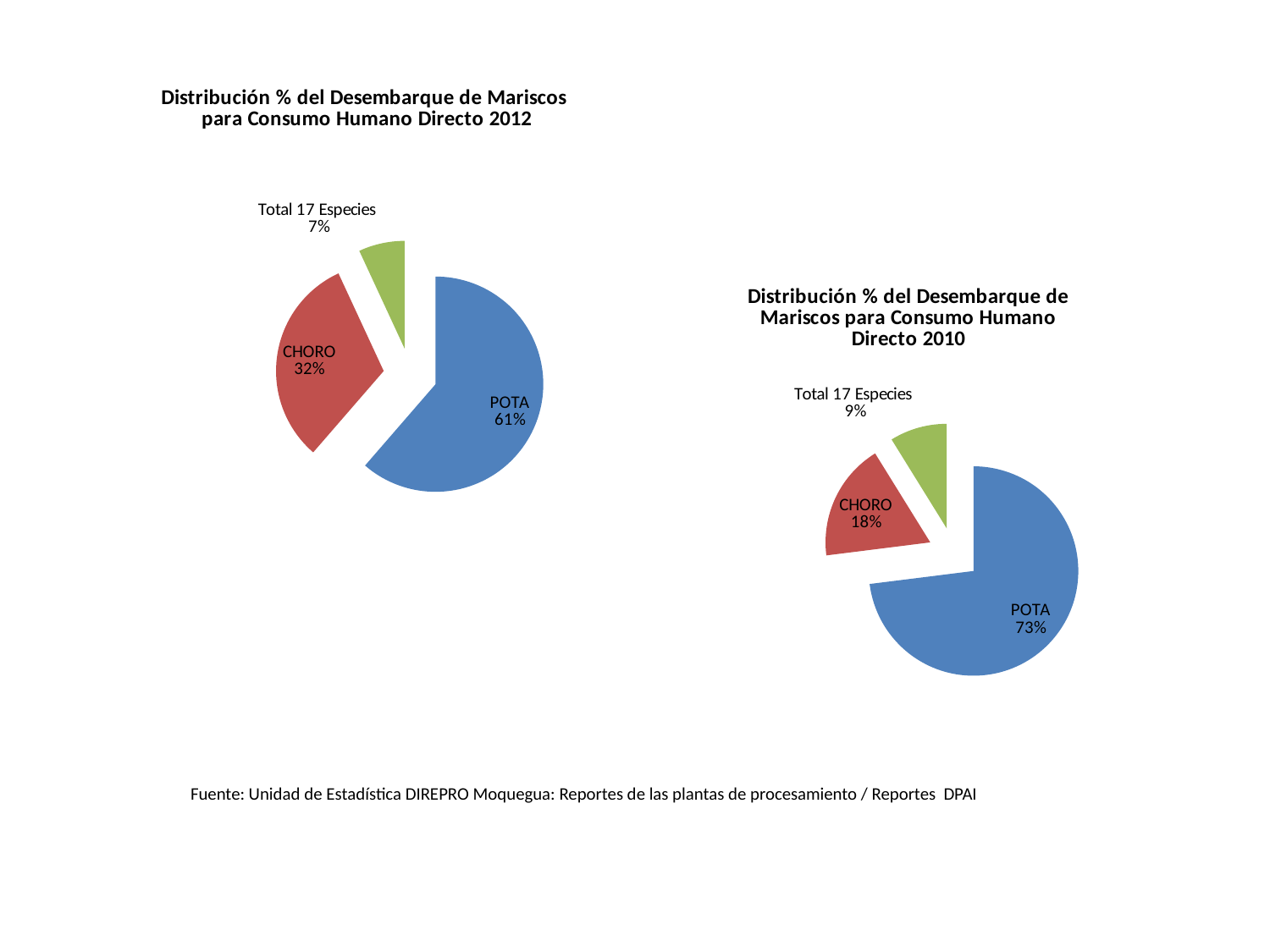
In the 2010 chart (right), what share does 'Total 17 Especies' have? 9% In the 2012 chart (left), what share does CHORO have? 32% In the 2012 chart (left), what share does 'Total 17 Especies' have? 7% In the 2010 chart (right), which category has the smallest slice? Total 17 Especies In the 2012 chart (left), what share does POTA have? 61% In the 2010 chart (right), what share does CHORO have? 18% Is the share of CHORO larger in the 2012 chart (left) or the 2010 chart (right)? 2012 chart (left) In the 2012 chart (left), what is the difference in percentage points between POTA and CHORO? 29 What type of chart is used on this slide? Pie chart In the 2010 chart (right), what share does POTA have? 73% How many slices does the 2010 chart (right) have? 3 In the 2012 chart (left), which category has the largest slice? POTA